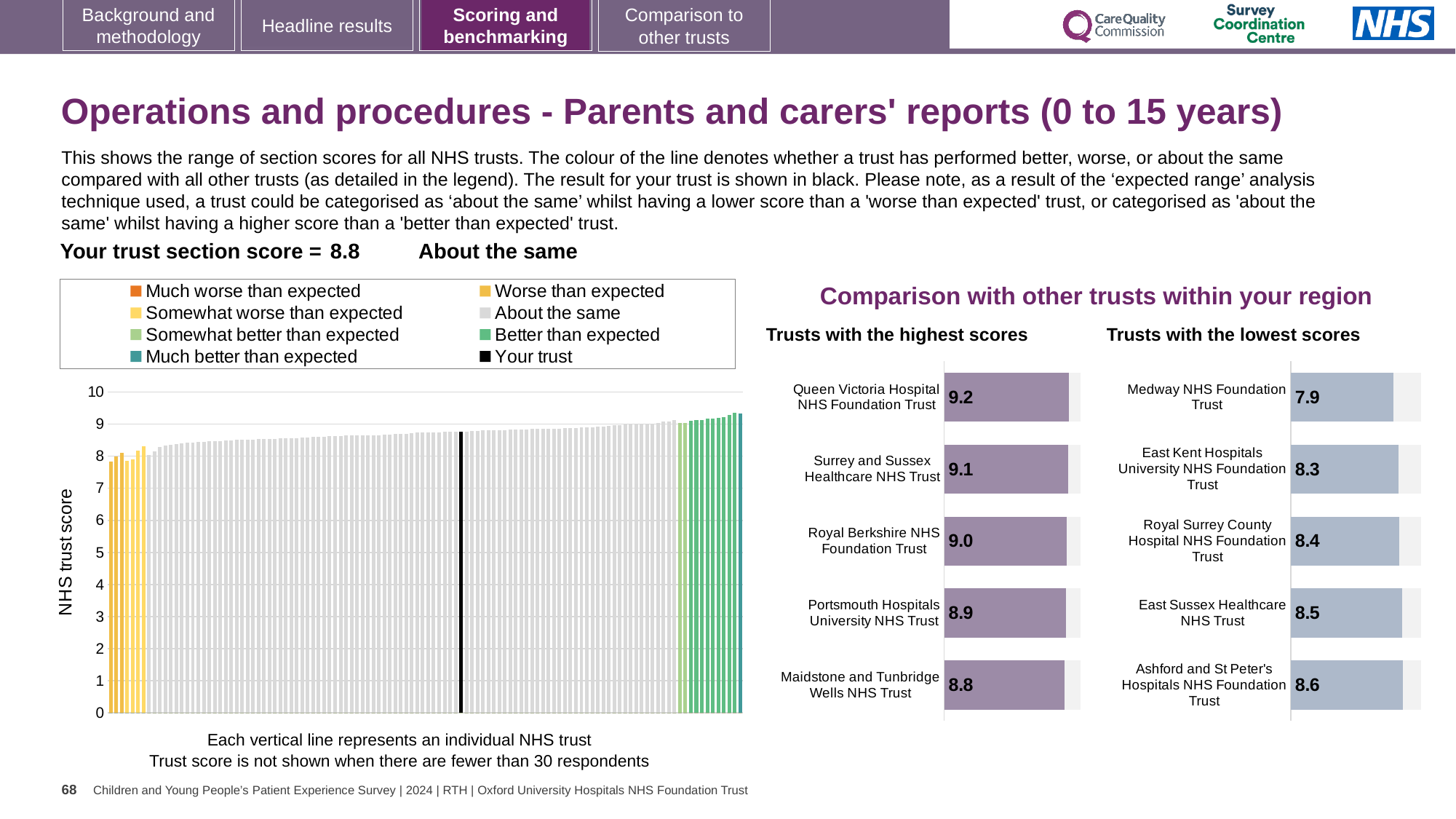
In the 'Trusts with the lowest scores' chart, what is the difference between the scores of Ashford and St Peter's Hospitals NHS Foundation Trust and Medway NHS Foundation Trust? 0.7 In the 'Trusts with the highest scores' chart, what is the difference between the scores of Queen Victoria Hospital NHS Foundation Trust and Maidstone and Tunbridge Wells NHS Trust? 0.4 In the large chart on the left, how many entries does the legend list? 8 In the large chart on the left, do the trust scores rise or fall from left to right along the x axis? Rise In the large chart on the left, is the value of the black bar (your trust) greater or less than 8? greater In the 'Trusts with the lowest scores' chart, what is the score for East Kent Hospitals University NHS Foundation Trust? 8.3 In the 'Trusts with the highest scores' chart, what is the score for Queen Victoria Hospital NHS Foundation Trust? 9.2 What kind of chart is the large chart on the left with the y axis labelled 'NHS trust score'? Bar chart In the 'Trusts with the lowest scores' chart, which trust has the lowest score? Medway NHS Foundation Trust In the 'Trusts with the highest scores' chart, what is the score for Royal Berkshire NHS Foundation Trust? 9.0 In the 'Trusts with the highest scores' chart, how many trusts are shown? 5 In the 'Trusts with the lowest scores' chart, which has the higher score: Royal Surrey County Hospital NHS Foundation Trust or Ashford and St Peter's Hospitals NHS Foundation Trust? Ashford and St Peter's Hospitals NHS Foundation Trust